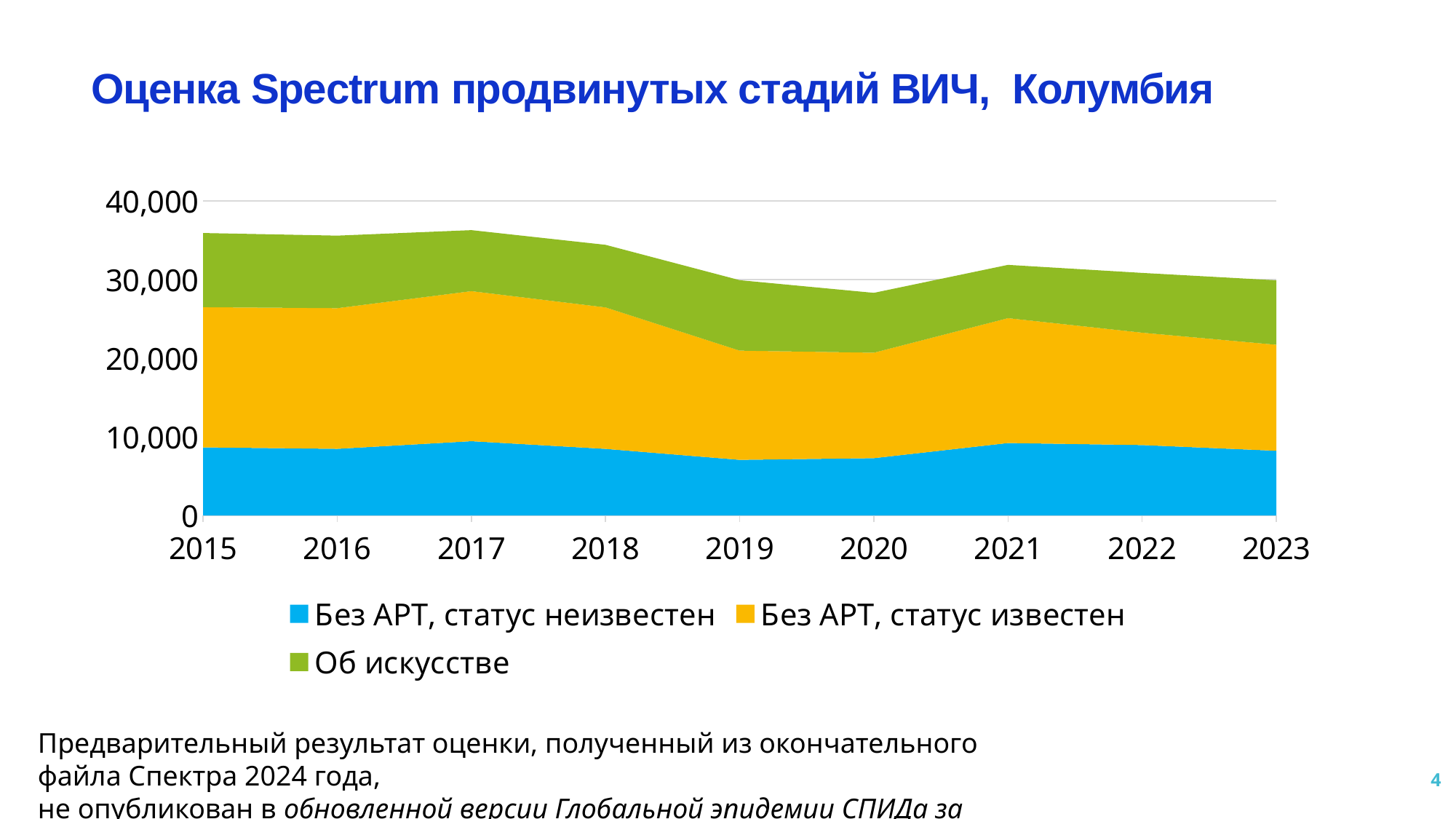
Is the total stacked value for 2015 greater or less than 30,000? greater How many series does the legend list? 3 What kind of chart is shown on the slide? Stacked area chart Which is larger, the total stacked value in 2015 or in 2020? 2015 How many years are plotted along the x axis? 9 Which series is shown in green? Об искусстве Is the value of 'Без АРТ, статус неизвестен' in 2019 greater or less than 10,000? less In which year is the total stacked value lowest? 2020 Is the total stacked value for 2020 greater or less than 30,000? less Does the total stacked value rise or fall from 2017 to 2020? fall What is the title of the chart? Оценка Spectrum продвинутых стадий ВИЧ, Колумбия